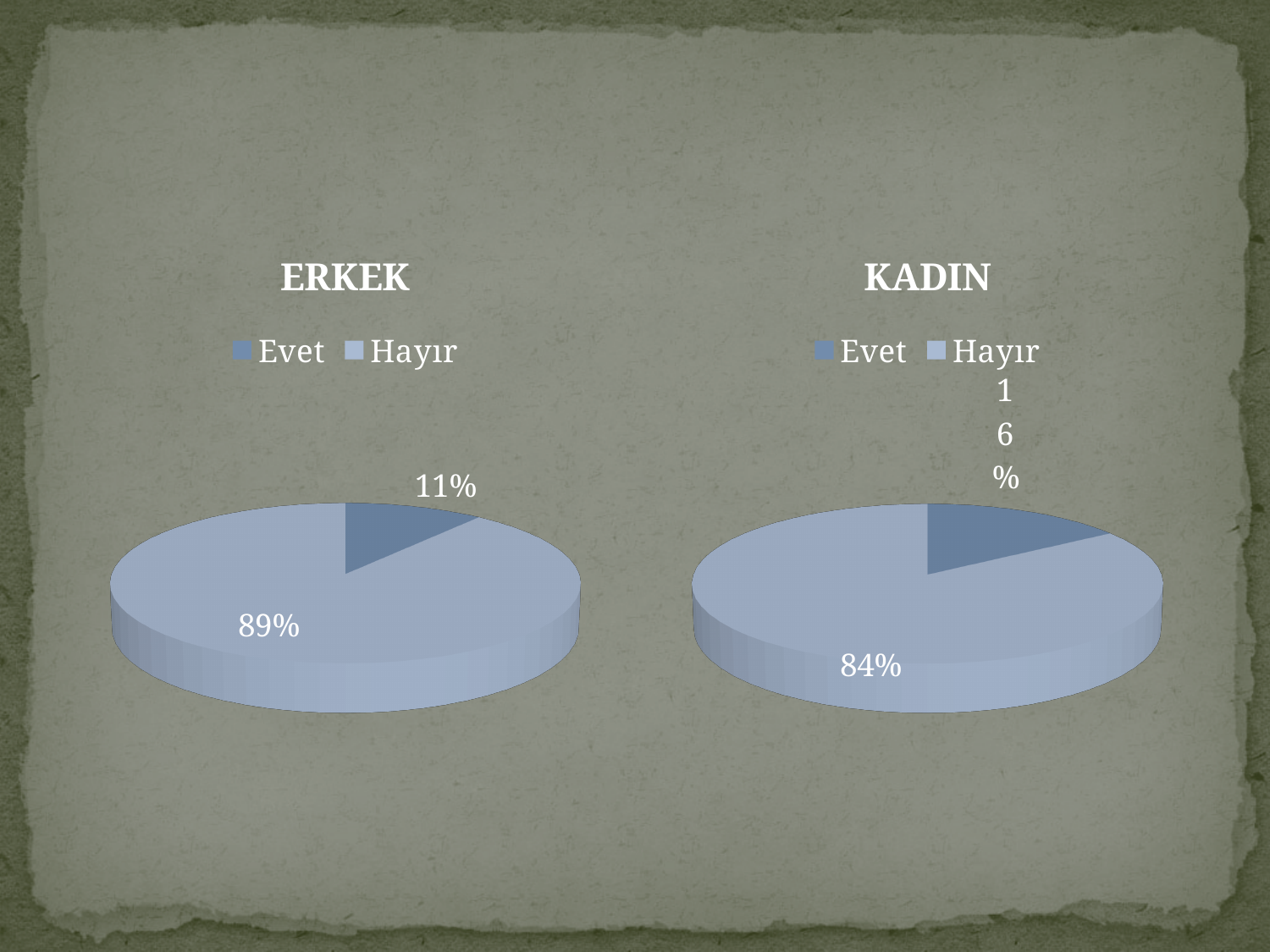
In the ERKEK chart, what is the difference between the Hayır and Evet shares? 78% What is the difference between the Hayır share in the ERKEK chart and the Hayır share in the KADIN chart? 5% What kind of chart is the ERKEK chart? Pie chart In the ERKEK chart, what share of the pie is Evet? 11% What are the legend entries in the KADIN chart? Evet, Hayır Which is larger: the Evet share in the ERKEK chart or the Evet share in the KADIN chart? KADIN How many slices does the KADIN pie chart have? 2 In the KADIN chart, which slice is the smallest? Evet In the ERKEK chart, which slice is the largest? Hayır In the ERKEK chart, what share of the pie is Hayır? 89% In the KADIN chart, what share of the pie is Hayır? 84%